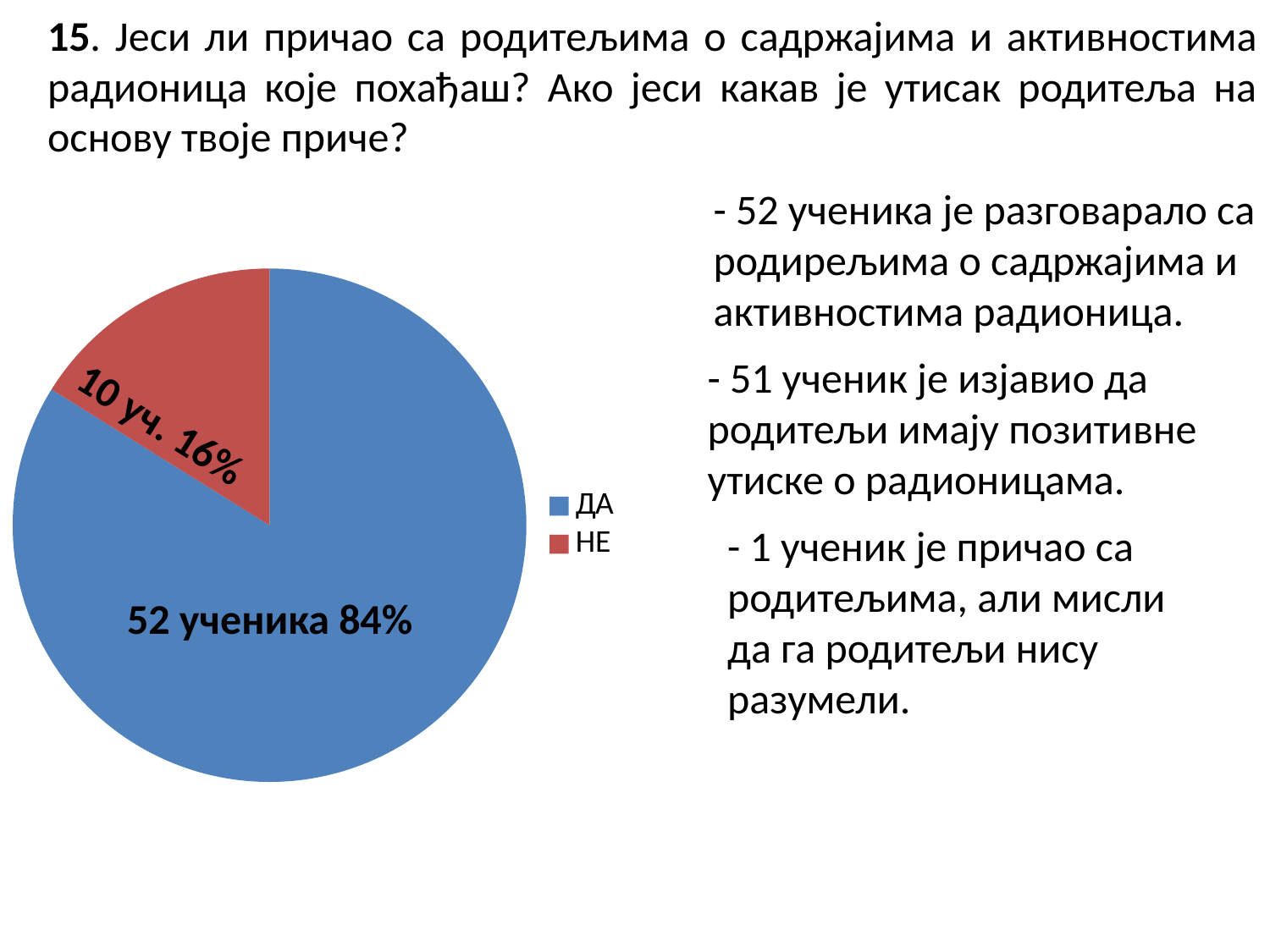
Which slice is the largest? ДА How many students are in the НЕ slice? 10 What kind of chart is shown on the slide? pie chart How many entries does the legend list? 2 What is the difference in number of students between the ДА and НЕ slices? 42 What colour is the ДА slice? blue Which slice is the smallest? НЕ How many students are in the ДА slice? 52 What percentage of the pie does the НЕ slice represent? 16% Which slice is larger, ДА or НЕ? ДА How many slices does the pie chart have? 2 What percentage of the pie does the ДА slice represent? 84%